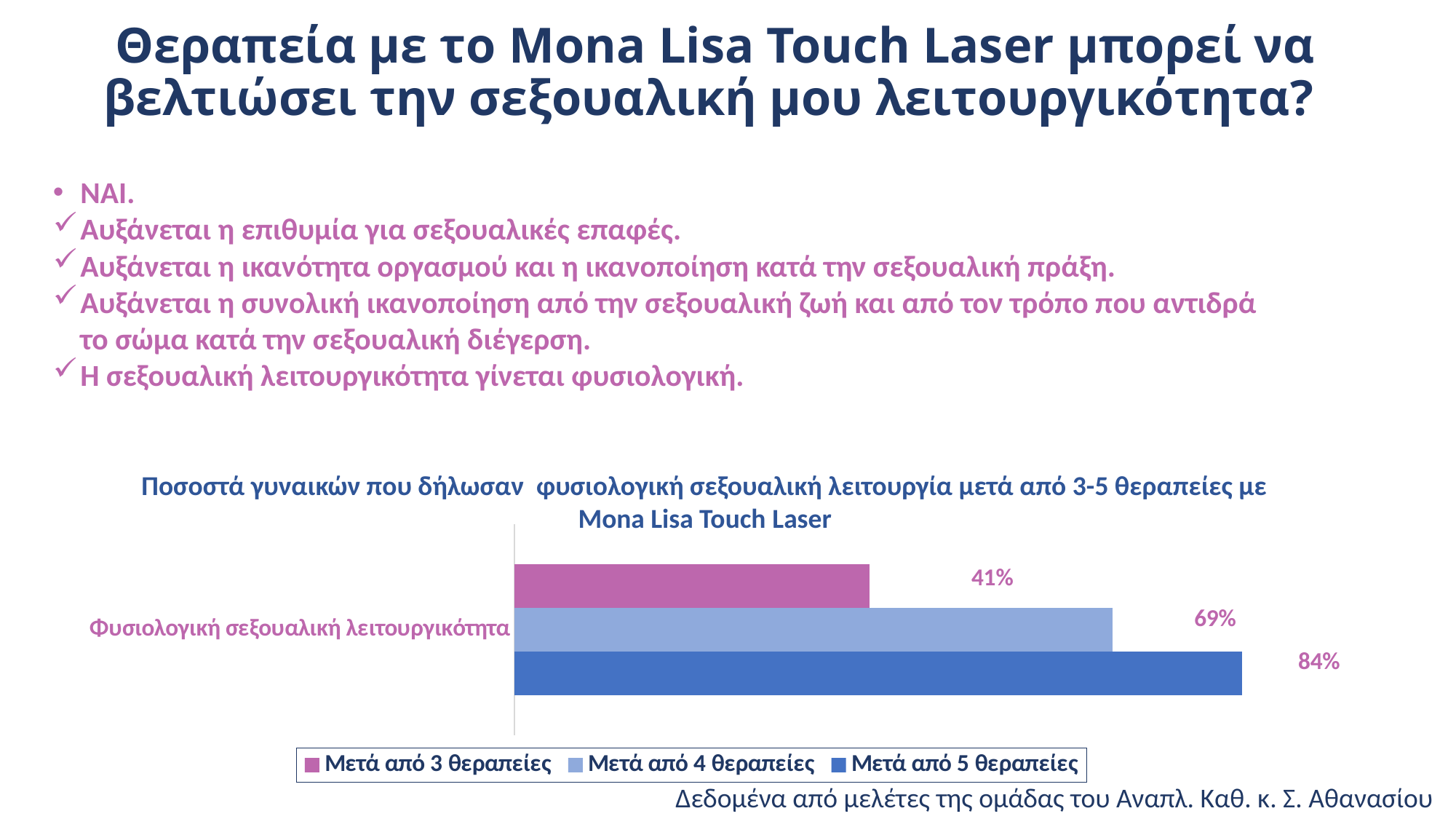
What percentage of women reported normal sexual function after 4 treatments (Μετά από 4 θεραπείες)? 69% How many series does the legend list? 3 Which series has the highest value in the chart? Μετά από 5 θεραπείες What percentage of women reported normal sexual function after 5 treatments (Μετά από 5 θεραπείες)? 84% Which is larger: the value after 4 treatments or the value after 5 treatments? Μετά από 5 θεραπείες What colour is the bar for 'Μετά από 3 θεραπείες'? Pink/magenta Do the values rise or fall as the number of treatments increases from 3 to 5? Rise What is the difference between the value after 5 treatments and the value after 3 treatments? 43% Which series has the lowest value in the chart? Μετά από 3 θεραπείες What percentage of women reported normal sexual function after 3 treatments (Μετά από 3 θεραπείες)? 41% What kind of chart is shown on the slide? Bar chart What is the difference between the value after 4 treatments and the value after 3 treatments? 28%